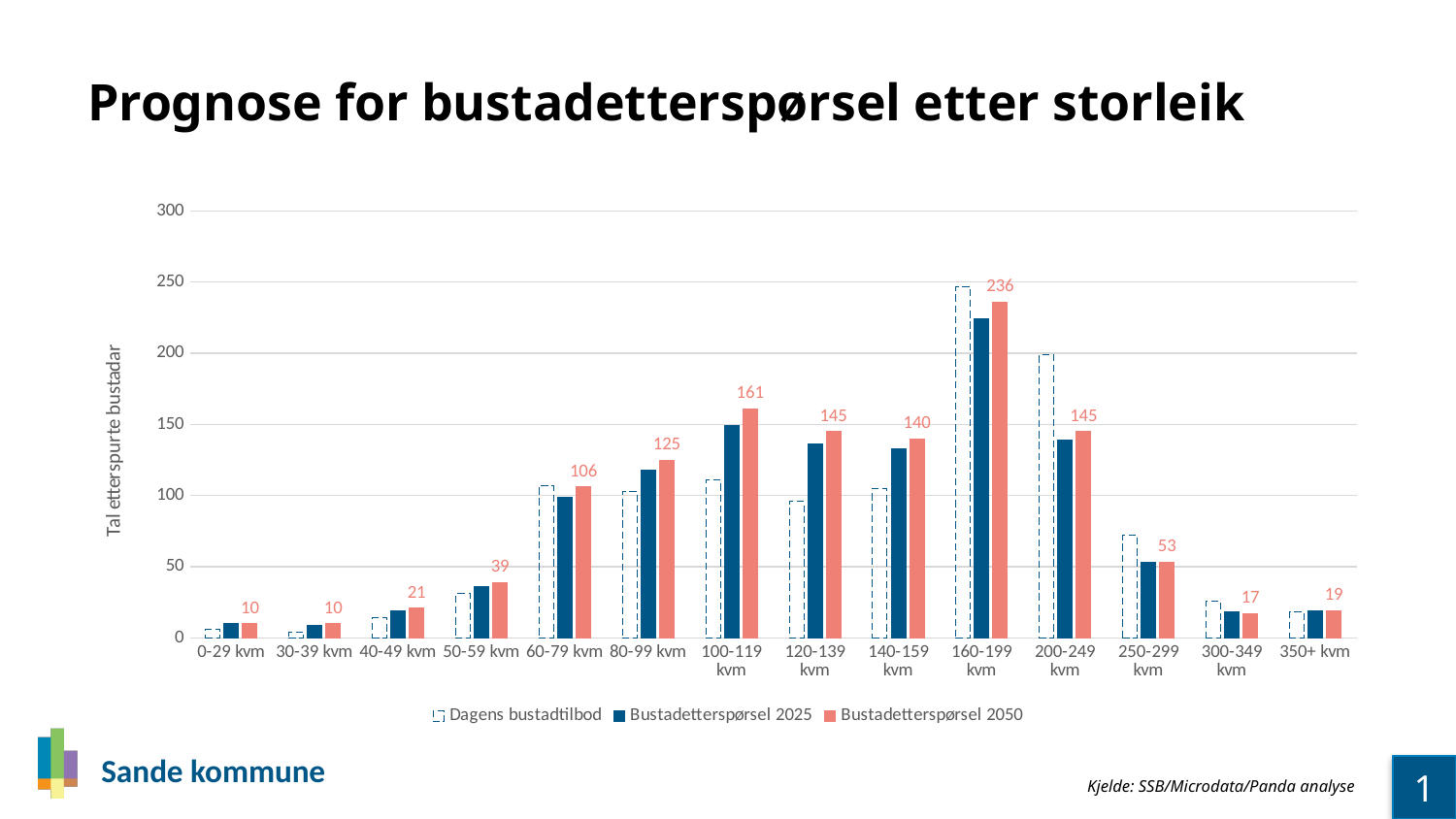
Which is larger for Bustadetterspørsel 2050: 80-99 kvm or 120-139 kvm? 120-139 kvm Which category has the highest Bustadetterspørsel 2050 value? 160-199 kvm What is the difference between the Bustadetterspørsel 2050 values for 160-199 kvm and 200-249 kvm? 91 How many size categories are shown on the x axis? 14 How many series does the legend list? 3 What is the title of the chart? Prognose for bustadetterspørsel etter storleik What is the Bustadetterspørsel 2050 value for 50-59 kvm? 39 What kind of chart is shown on the slide? bar chart Is the Dagens bustadtilbod value for 160-199 kvm greater or less than 200? greater What is the Bustadetterspørsel 2050 value for 160-199 kvm? 236 What is the Bustadetterspørsel 2050 value for 100-119 kvm? 161